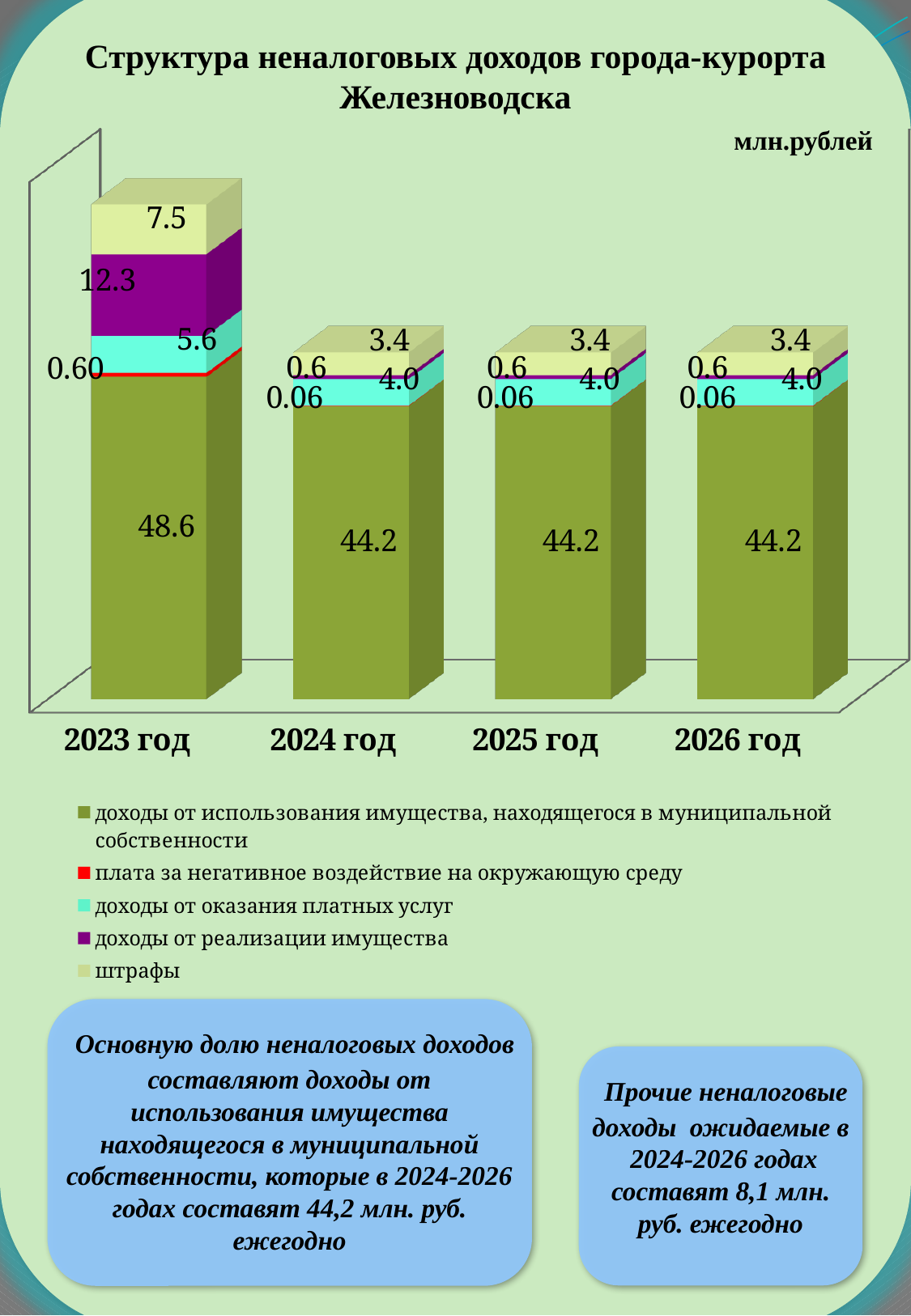
What is the value for доходы от оказания платных услуг in 2026 год? 4.0 What is the value for доходы от использования имущества, находящегося в муниципальной собственности in 2023 год? 48.6 How many series does the chart legend list? 5 What is the value for доходы от реализации имущества in 2023 год? 12.3 How many years (categories) are shown on the x axis of the chart? 4 What is the total of the stacked bar for 2023 год? 74.6 What is the difference between the штрафы value in 2023 год and in 2024 год? 4.1 What is the value for доходы от использования имущества, находящегося в муниципальной собственности in 2025 год? 44.2 What is the value for штрафы in 2023 год? 7.5 What unit is stated for the values in the chart? млн.рублей What kind of chart is shown on the slide? stacked bar chart Which year has the highest value for доходы от использования имущества, находящегося в муниципальной собственности? 2023 год